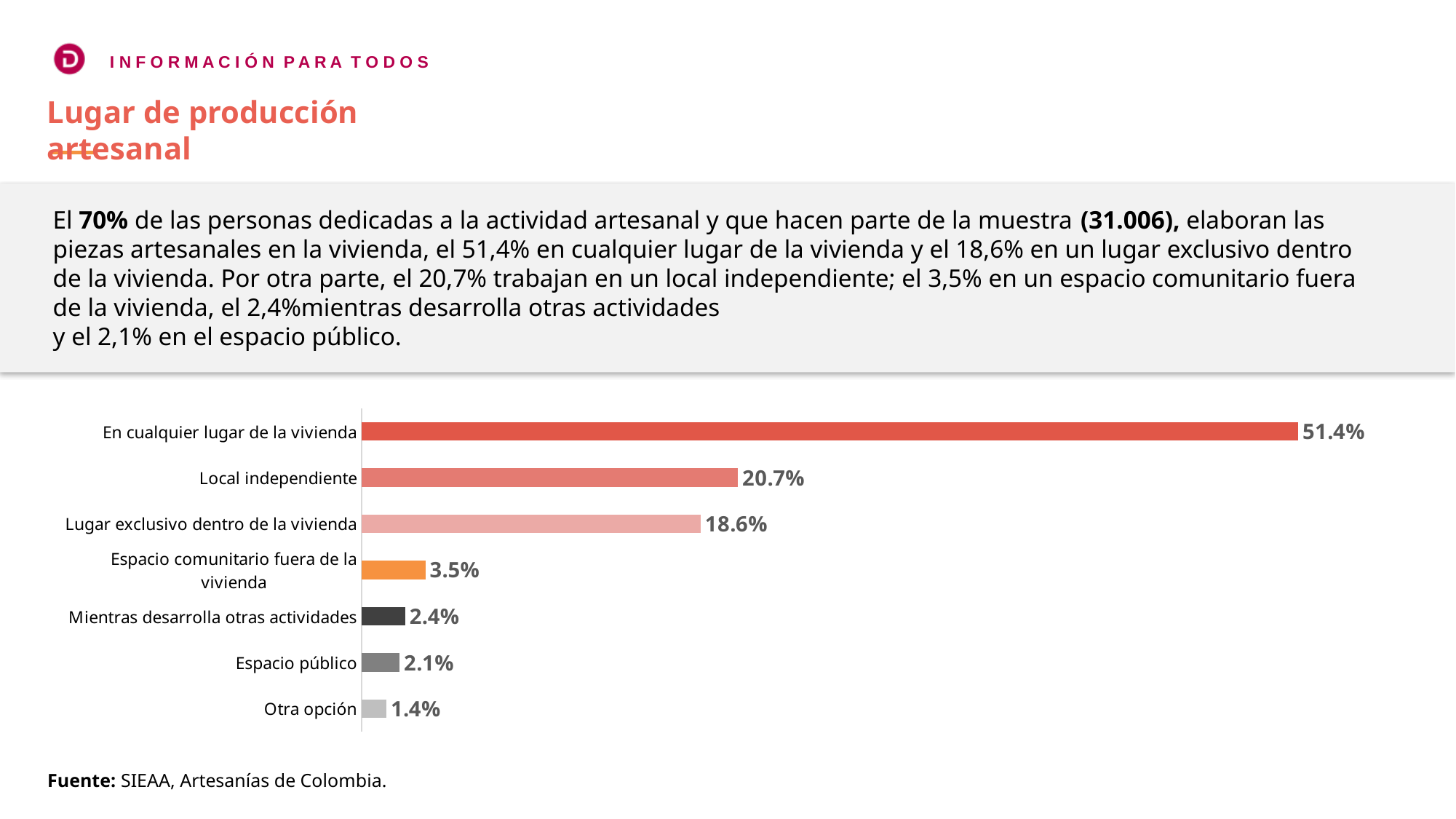
What is the difference between "En cualquier lugar de la vivienda" and "Local independiente"? 30.7% Which is larger, "Mientras desarrolla otras actividades" or "Espacio público"? Mientras desarrolla otras actividades What kind of chart is shown on the slide? Bar chart How many categories are shown in the chart? 7 What is the value for "Espacio comunitario fuera de la vivienda"? 3.5% What is the value for "En cualquier lugar de la vivienda"? 51.4% Which category has the highest value? En cualquier lugar de la vivienda What is the value for "Local independiente"? 20.7% What is the difference between "Local independiente" and "Lugar exclusivo dentro de la vivienda"? 2.1% Which category has the lowest value? Otra opción What colour is the bar for "Espacio comunitario fuera de la vivienda"? Orange What is the value for "Otra opción"? 1.4%